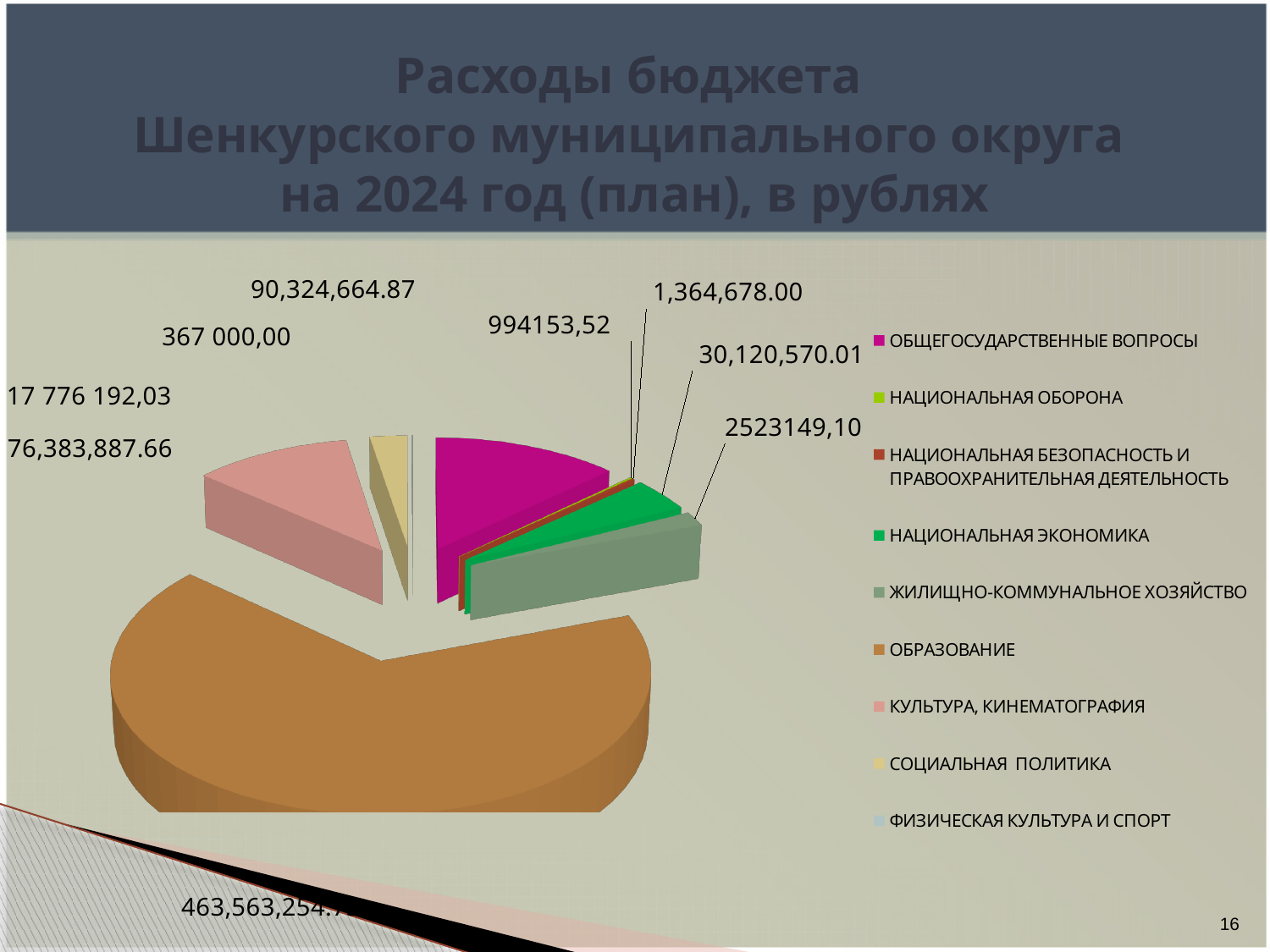
Which category has the largest slice in the pie chart? ОБРАЗОВАНИЕ Which legend entry is shown in brown? ОБРАЗОВАНИЕ How many categories does the legend of the pie chart list? 9 Which slice is larger, КУЛЬТУРА, КИНЕМАТОГРАФИЯ or СОЦИАЛЬНАЯ ПОЛИТИКА? КУЛЬТУРА, КИНЕМАТОГРАФИЯ What is the title of the chart on the slide? Расходы бюджета Шенкурского муниципального округа на 2024 год (план), в рублях Which slice is larger, ОБРАЗОВАНИЕ or КУЛЬТУРА, КИНЕМАТОГРАФИЯ? ОБРАЗОВАНИЕ What kind of chart is shown on the slide? pie chart What value is labelled for the КУЛЬТУРА, КИНЕМАТОГРАФИЯ slice? 76,383,887.66 Which category is listed last in the legend? ФИЗИЧЕСКАЯ КУЛЬТУРА И СПОРТ Which slice is larger, ОБЩЕГОСУДАРСТВЕННЫЕ ВОПРОСЫ or НАЦИОНАЛЬНАЯ ЭКОНОМИКА? ОБЩЕГОСУДАРСТВЕННЫЕ ВОПРОСЫ